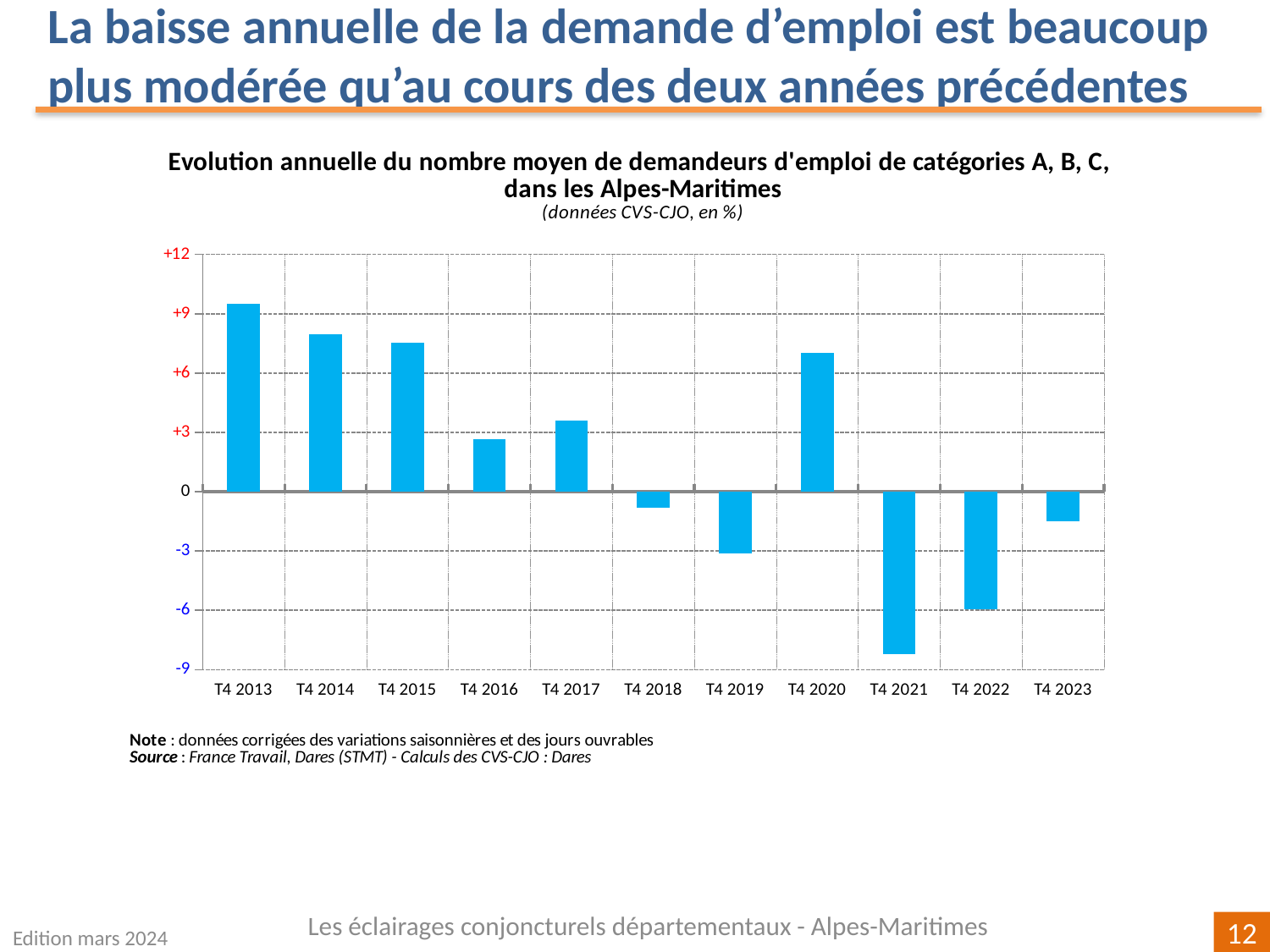
Is the value for T4 2020 greater or less than +6? greater Is the value for T4 2016 greater or less than +3? less Which period has the highest value on the chart? T4 2013 What kind of chart is shown on the slide? bar chart How many periods (bars) are plotted on the chart? 11 Which period has the lowest value on the chart? T4 2021 In what unit are the chart's data expressed, according to the subtitle? en % Which is larger, the value for T4 2017 or the value for T4 2020? T4 2020 Which is larger, the value for T4 2022 or the value for T4 2023? T4 2023 Is the value for T4 2023 greater or less than -3? greater